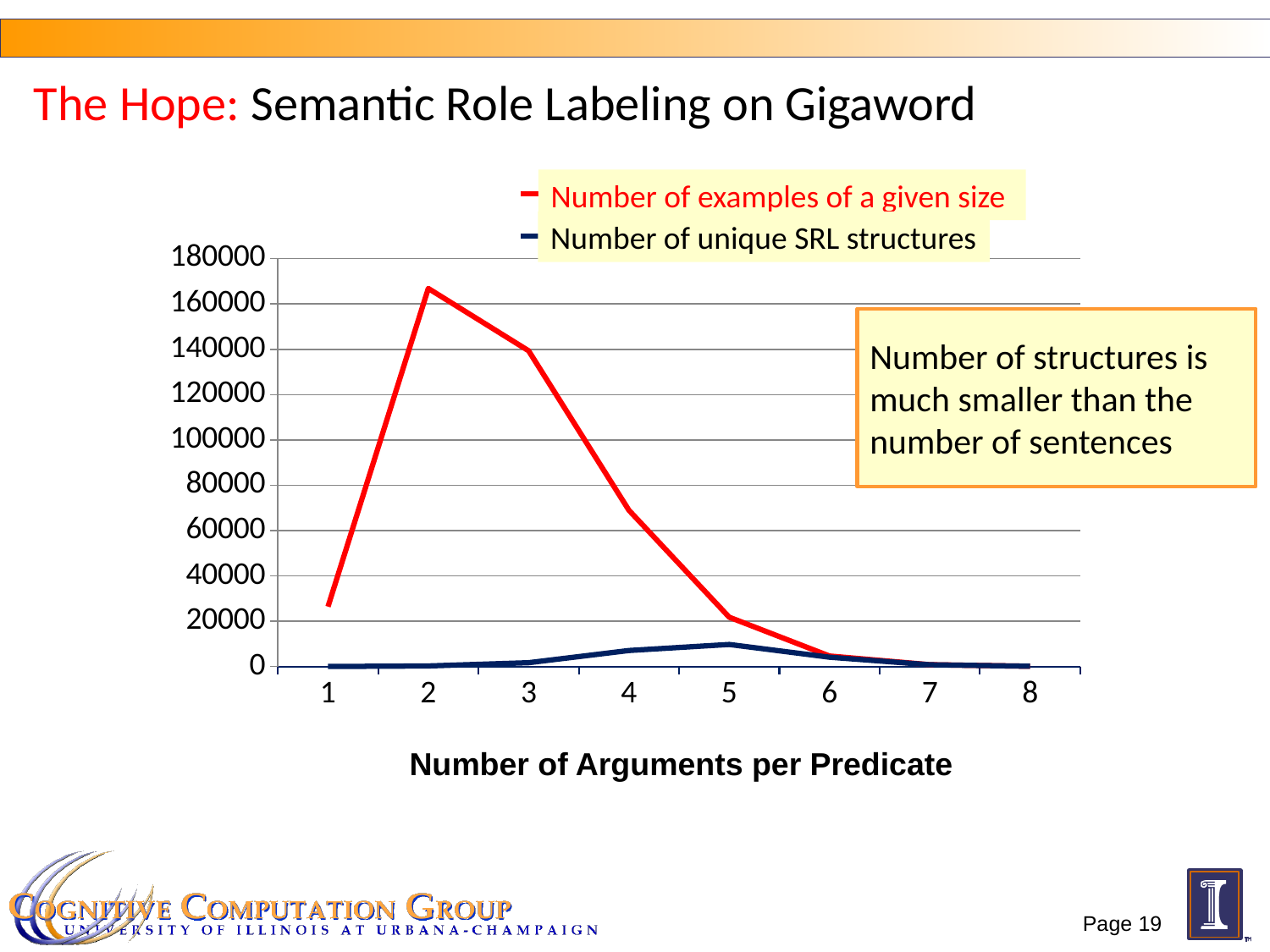
What kind of chart is shown on the slide? line chart What is the title of the x axis? Number of Arguments per Predicate At which number of arguments per predicate does the 'Number of examples of a given size' line reach its highest value? 2 Is the value of 'Number of examples of a given size' at 4 arguments greater or less than 80000? less Is the value of 'Number of examples of a given size' at 3 arguments greater or less than 120000? greater Is the value of 'Number of examples of a given size' at 5 arguments greater or less than 40000? less At 2 arguments per predicate, which series has the larger value: 'Number of examples of a given size' or 'Number of unique SRL structures'? Number of examples of a given size How many points along the x axis does each line have? 8 How many series does the legend list? 2 From 2 to 8 arguments per predicate, does the 'Number of examples of a given size' line rise or fall? fall